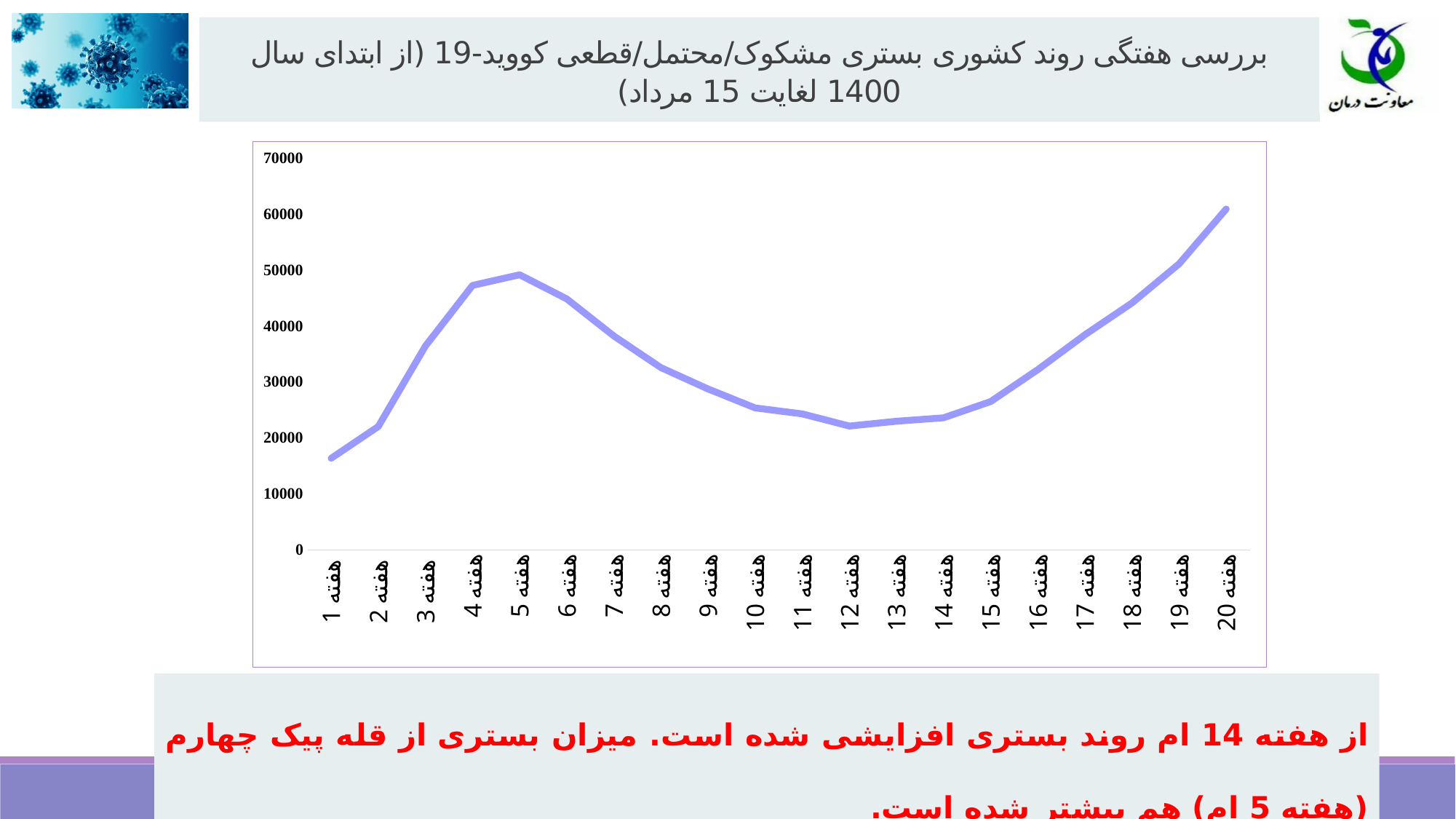
What kind of chart is shown on the slide? line chart Is the value for هفته 5 greater or less than 40000? greater How many weeks (هفته) are plotted along the x axis of the chart? 20 Which is larger, the value for هفته 4 or the value for هفته 16? هفته 4 Which is larger, the value for هفته 20 or the value for هفته 5? هفته 20 Do the values rise or fall from هفته 14 to هفته 20? rise Is the value for هفته 20 greater or less than 50000? greater Which week has the highest value on the chart? هفته 20 Is the value for هفته 10 greater or less than 30000? less Do the values rise or fall from هفته 5 to هفته 12? fall Which week has the lowest value on the chart? هفته 1